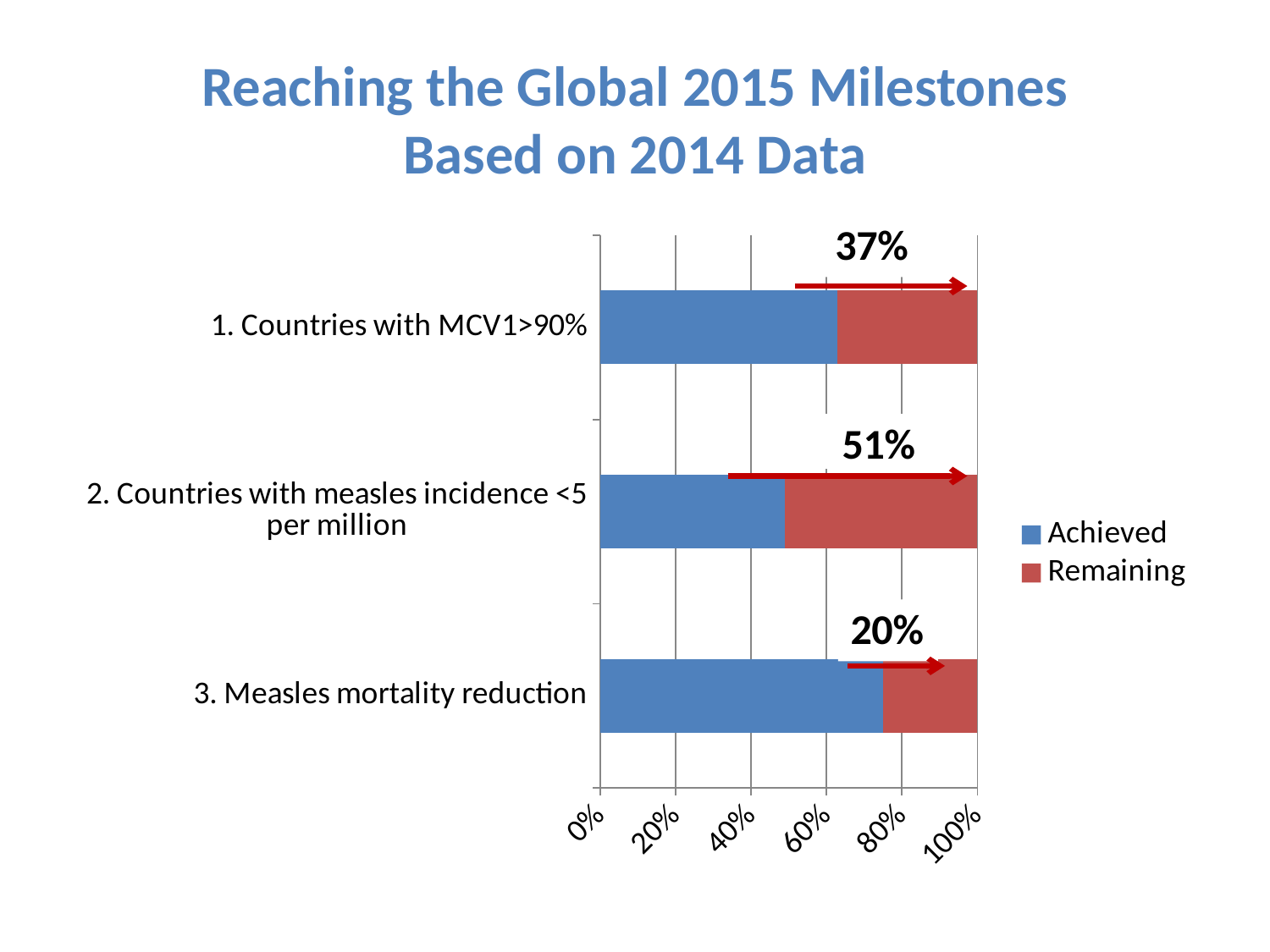
How many categories (milestones) are plotted in the chart? 3 Which has a larger Achieved share: 1. Countries with MCV1>90% or 2. Countries with measles incidence <5 per million? 1. Countries with MCV1>90% Is the Achieved value for 2. Countries with measles incidence <5 per million greater or less than 60%? less Is the Achieved value for 1. Countries with MCV1>90% greater or less than 60%? greater What percentage label is printed above the bar for 1. Countries with MCV1>90%? 37% What percentage label is printed above the bar for 2. Countries with measles incidence <5 per million? 51% What kind of chart is shown on the slide? bar chart Which milestone has the smallest Achieved share? 2. Countries with measles incidence <5 per million Which milestone has the largest Achieved share? 3. Measles mortality reduction Is the Achieved value for 3. Measles mortality reduction greater or less than 80%? less What are the two series named in the legend? Achieved and Remaining How many series does the chart legend list? 2